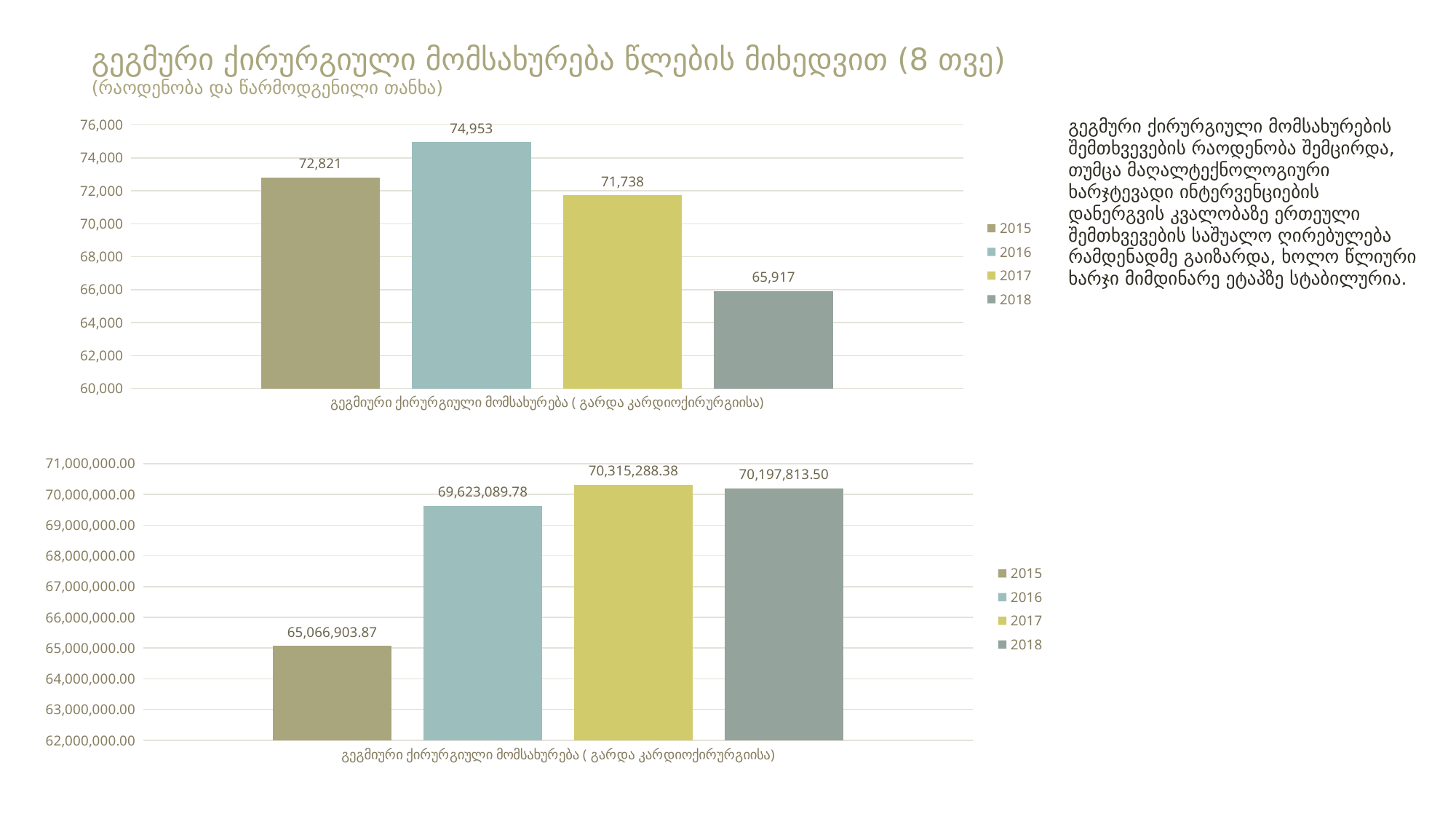
What kind of chart is the top chart? bar chart In the bottom chart, what is the value for 2017? 70,315,288.38 How many series does the legend of the bottom chart list? 4 In the top chart, which year has the lowest value? 2018 In the bottom chart, what is the value for 2015? 65,066,903.87 In the top chart, what is the value for 2016? 74,953 In the bottom chart, which is larger, the value for 2016 or the value for 2015? 2016 In the top chart, what is the difference between the values for 2016 and 2018? 9,036 In the top chart, is the value for 2015 greater or less than 72,000? greater In the top chart, which year has the highest value? 2016 In the top chart, what is the value for 2018? 65,917 In the bottom chart, which year has the lowest value? 2015